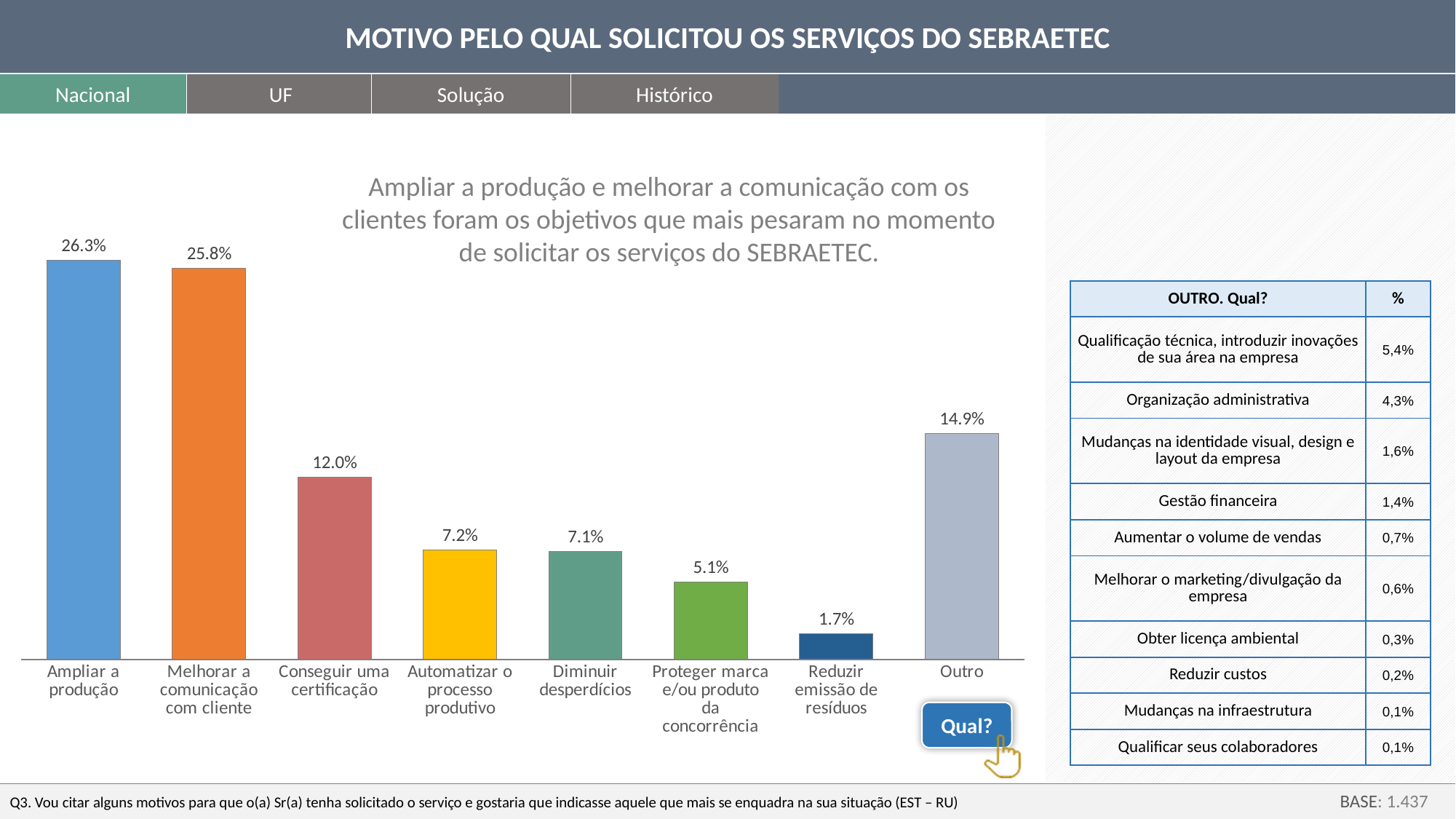
What is the value for "Outro"? 14.9% Which category has the lowest value? Reduzir emissão de resíduos What is the value for "Reduzir emissão de resíduos"? 1.7% What is the difference between "Ampliar a produção" and "Melhorar a comunicação com cliente"? 0.5% What is the value for "Conseguir uma certificação"? 12.0% Which is larger: "Conseguir uma certificação" or "Outro"? Outro What is the difference between "Automatizar o processo produtivo" and "Proteger marca e/ou produto da concorrência"? 2.1% What is the value for "Ampliar a produção"? 26.3% What colour is the bar for "Melhorar a comunicação com cliente"? Orange How many categories are shown in the bar chart? 8 Which category has the highest value? Ampliar a produção What kind of chart is shown on the slide? Bar chart